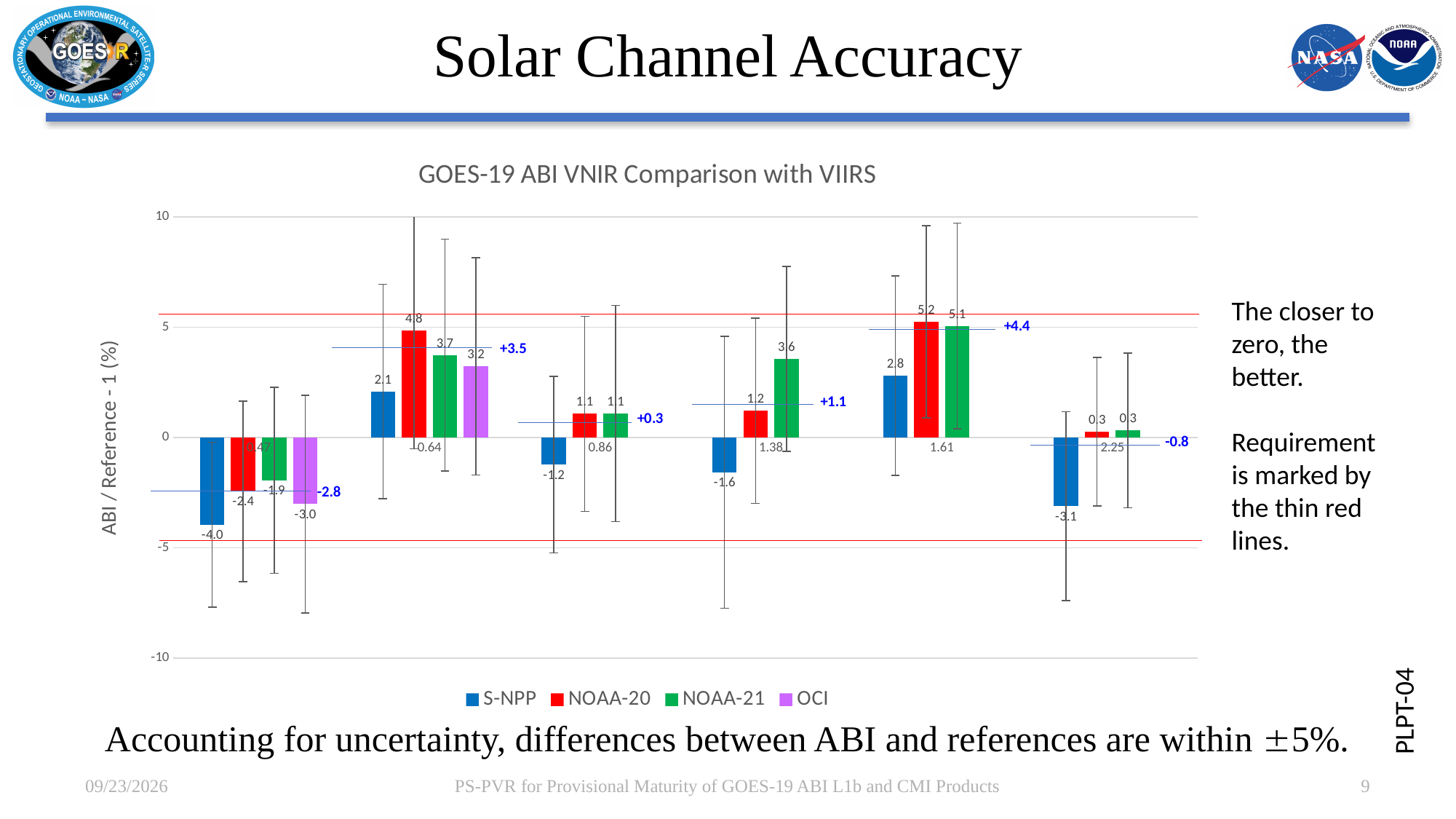
What is the S-NPP value for the 2.25 channel? -3.1 Which series has the highest value for the 1.61 channel? NOAA-20 What is the NOAA-20 value for the 0.64 channel? 4.8 What is the NOAA-21 value for the 1.38 channel? 3.6 How many series does the chart legend list? 4 What type of chart is shown on the slide? bar chart What is the OCI value for the 0.47 channel? -3.0 Which series has the lowest value for the 0.47 channel? S-NPP What is the title of the chart? GOES-19 ABI VNIR Comparison with VIIRS What is the S-NPP value for the 0.47 channel? -4.0 Which is larger for the 1.38 channel, the NOAA-20 value or the NOAA-21 value? NOAA-21 What is the difference between the NOAA-20 and S-NPP values for the 0.64 channel? 2.7